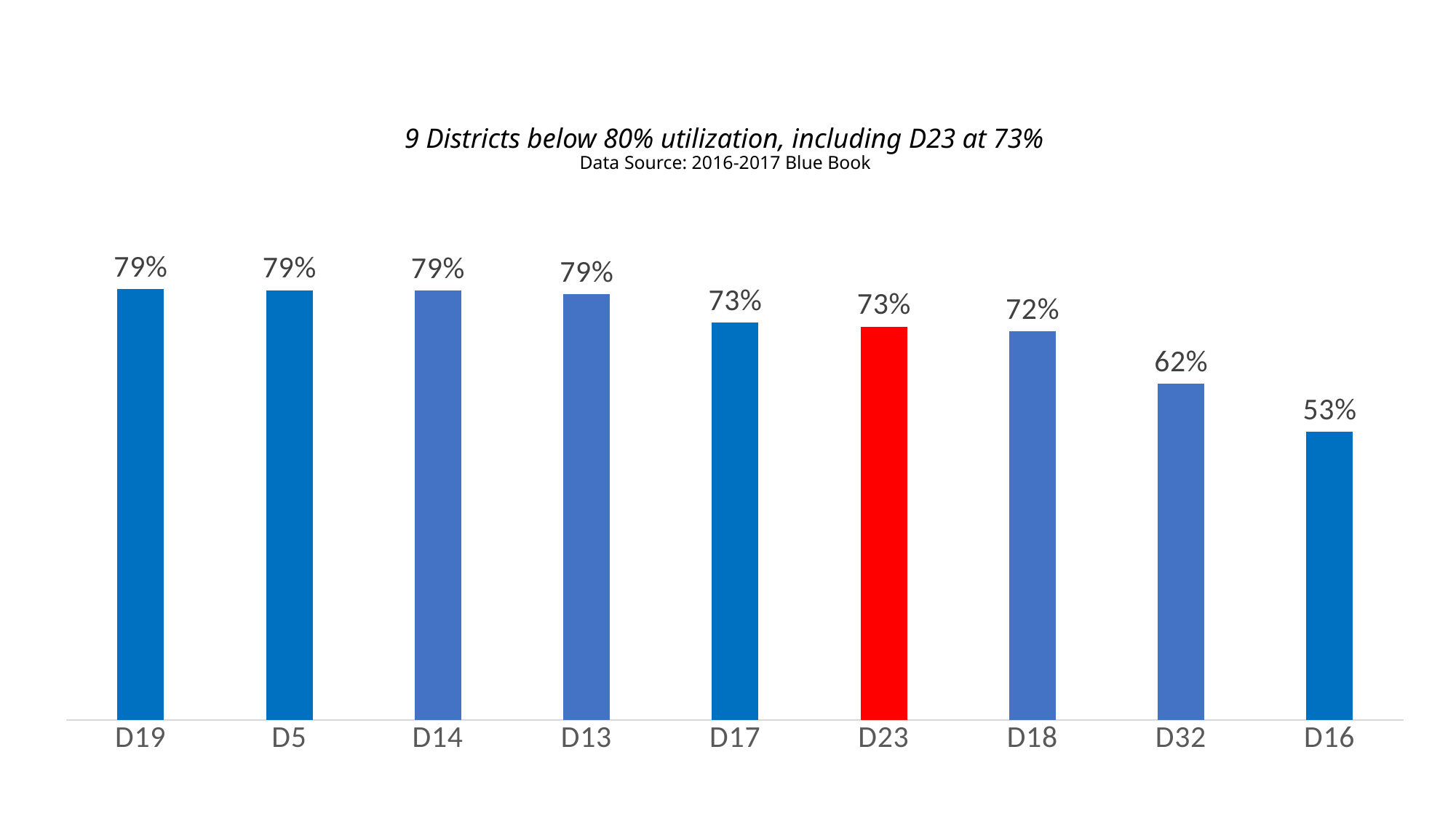
What is the utilization value for D16? 53% What kind of chart is shown on the slide? Bar chart How many districts are shown in the chart? 9 Which has a higher utilization, D18 or D32? D18 Do the values rise or fall from left to right along the x axis? Fall What is the difference between the utilization of D19 and D16? 26% What is the utilization value for D32? 62% Which district's bar is coloured red? D23 Which district has the lowest utilization? D16 What is the difference between the utilization of D23 and D32? 11% What is the utilization value for D23? 73% What is the utilization value for D18? 72%